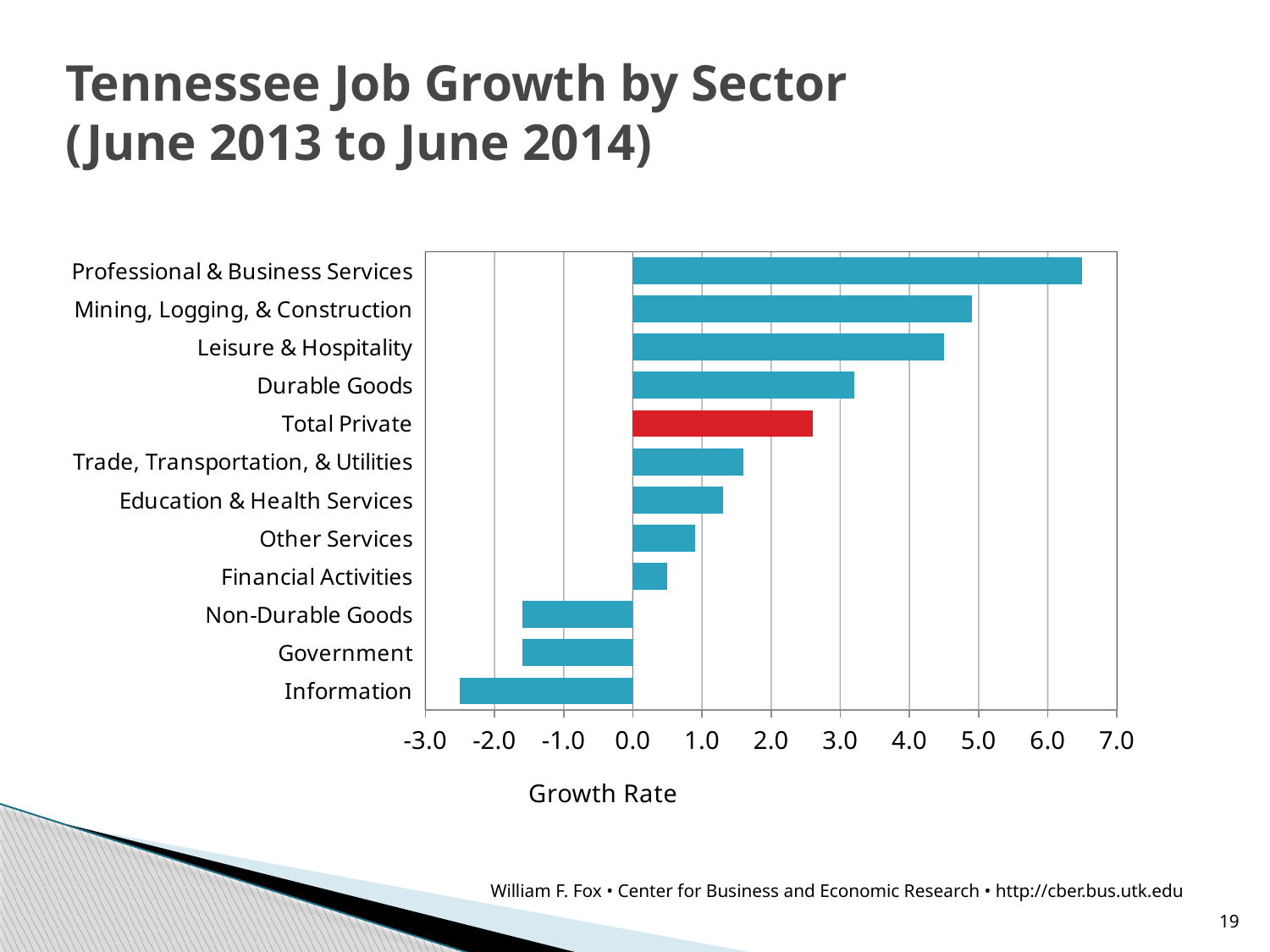
Is the growth rate for Total Private greater or less than 2.0? greater Is the growth rate for Mining, Logging, & Construction greater or less than 4.0? greater Which sector has the lowest growth rate? Information Is the growth rate for Financial Activities greater or less than 1.0? less Which has the larger growth rate, Trade, Transportation, & Utilities or Education & Health Services? Trade, Transportation, & Utilities How many sectors are plotted in the chart? 12 What kind of chart is shown on the slide? bar chart Which bar in the chart is coloured red? Total Private Which has the larger growth rate, Leisure & Hospitality or Durable Goods? Leisure & Hospitality Which sector has the highest growth rate? Professional & Business Services